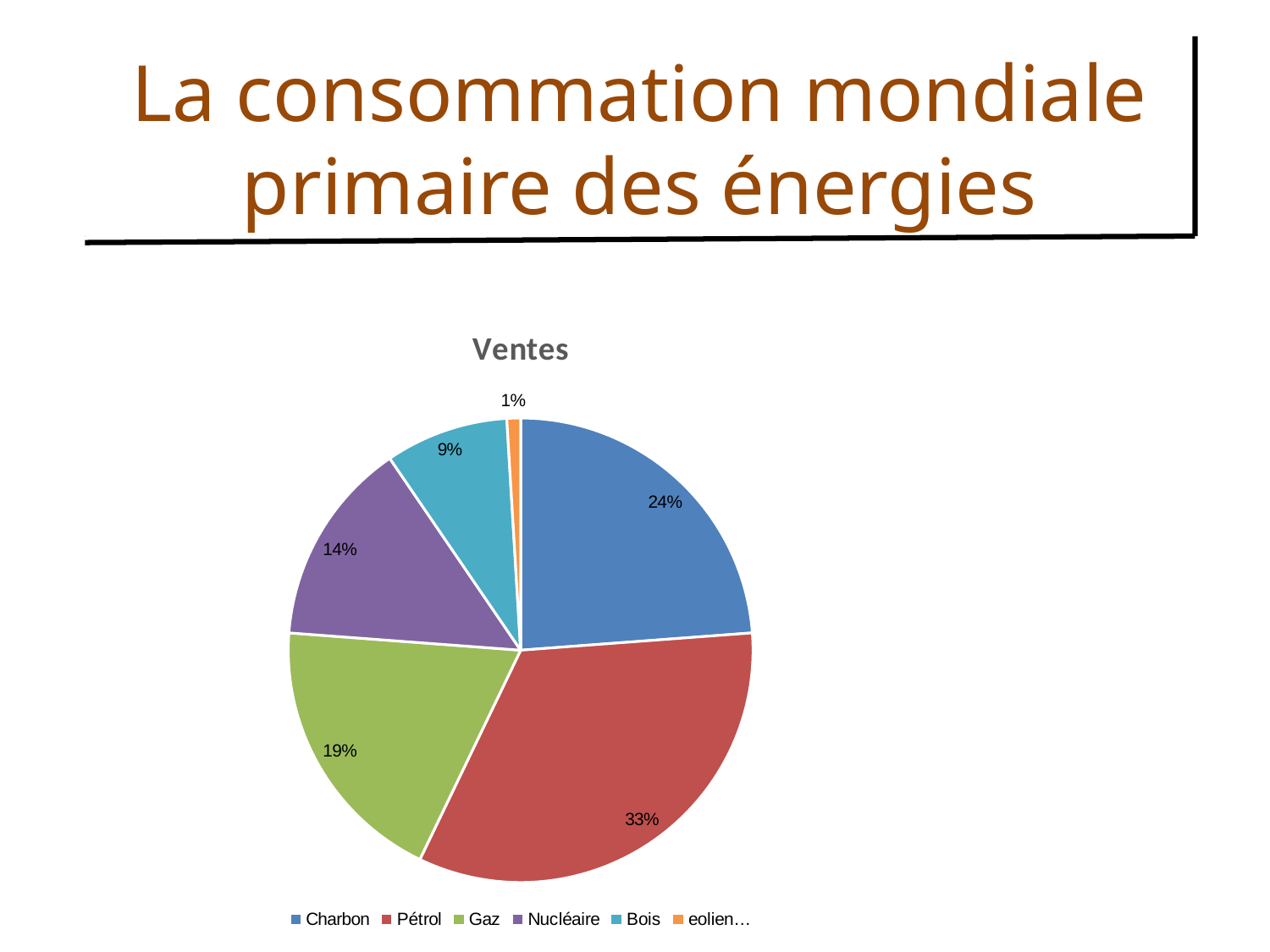
What share of the pie does Bois take? 9% What kind of chart is shown on the slide? pie chart What share of the pie does Nucléaire take? 14% What share of the pie does Pétrol take? 33% What is the chart's title? Ventes What is the difference in percentage points between the Pétrol and Charbon shares? 9 Which category has the largest slice of the pie? Pétrol What colour is the Nucléaire slice? purple Which of Charbon and Gaz has the larger share? Charbon How many slices does the pie chart have? 6